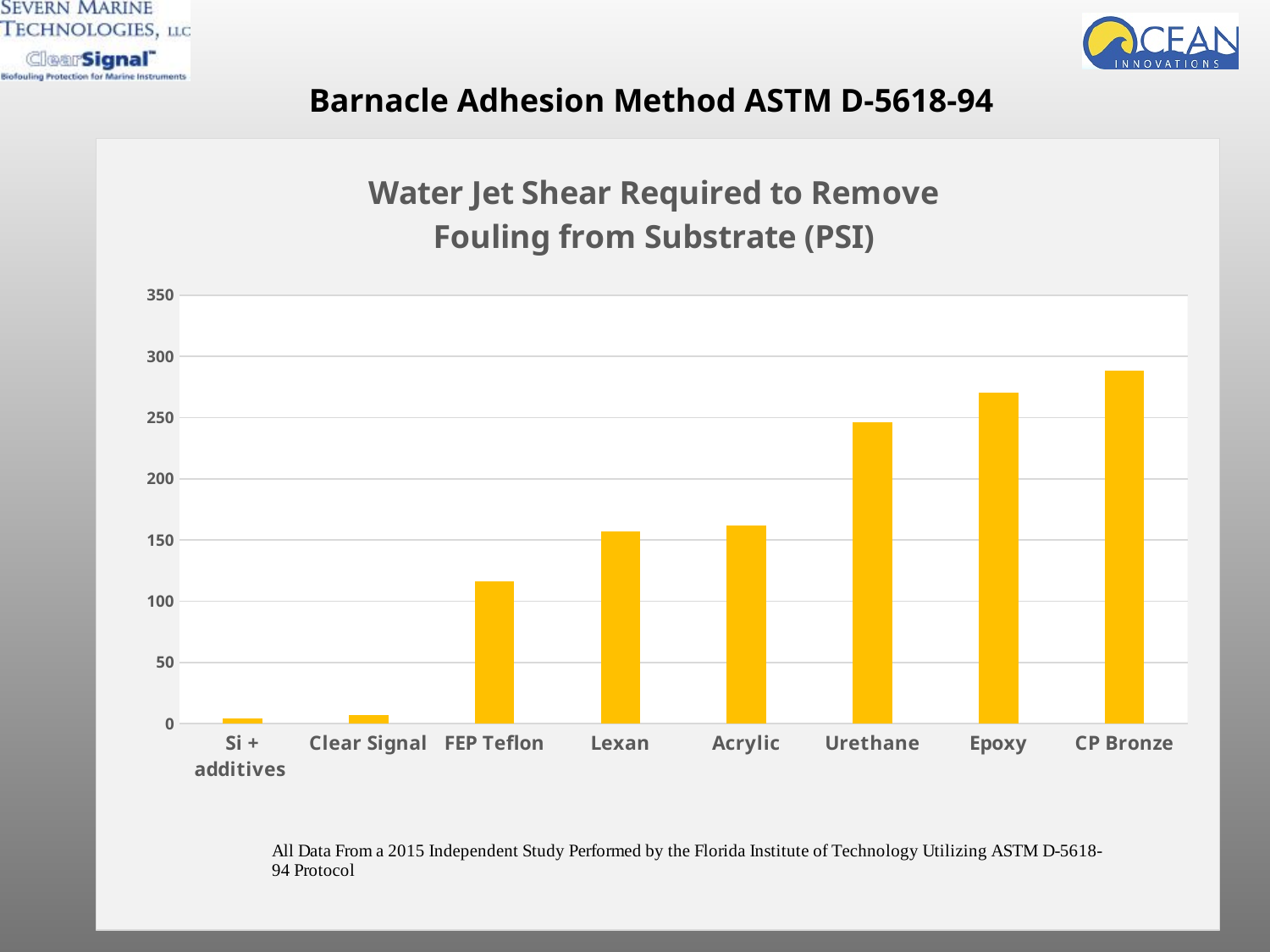
Which has a larger value, Urethane or Lexan? Urethane Is the value for FEP Teflon greater or less than 150? less Do the values rise or fall moving from left to right across the categories? rise What is the title of the chart? Water Jet Shear Required to Remove Fouling from Substrate (PSI) Is the value for Urethane greater or less than 200? greater What kind of chart is shown on the slide? bar chart Is the value for CP Bronze greater or less than 250? greater Which has a larger value, FEP Teflon or Epoxy? Epoxy How many substrate categories are plotted on the chart? 8 Which substrate requires the highest water jet shear to remove fouling? CP Bronze